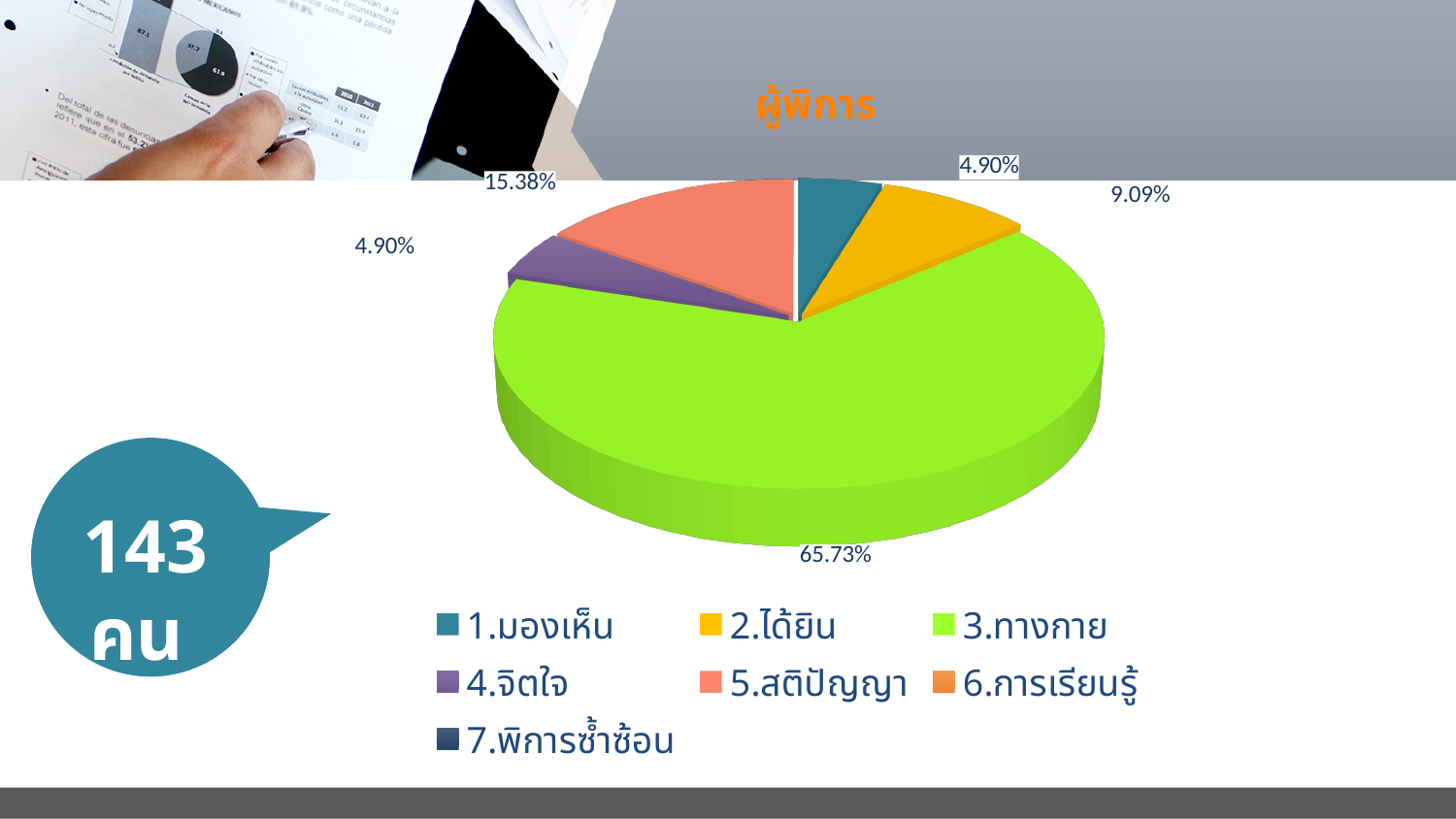
What percentage is shown for 1.มองเห็น? 4.90% What colour represents 3.ทางกาย in the pie chart? green What kind of chart is shown on the slide? pie chart What is the difference in percentage points between 5.สติปัญญา and 2.ได้ยิน? 6.29% What is the title of the pie chart? ผู้พิการ What is the difference in percentage points between 3.ทางกาย and 5.สติปัญญา? 50.35% How many entries does the legend of the pie chart list? 7 Which is larger, the share for 5.สติปัญญา or the share for 2.ได้ยิน? 5.สติปัญญา What percentage is shown for 5.สติปัญญา? 15.38% What percentage is shown for 2.ได้ยิน? 9.09% Which category has the largest share of the pie? 3.ทางกาย What percentage is shown for 3.ทางกาย? 65.73%